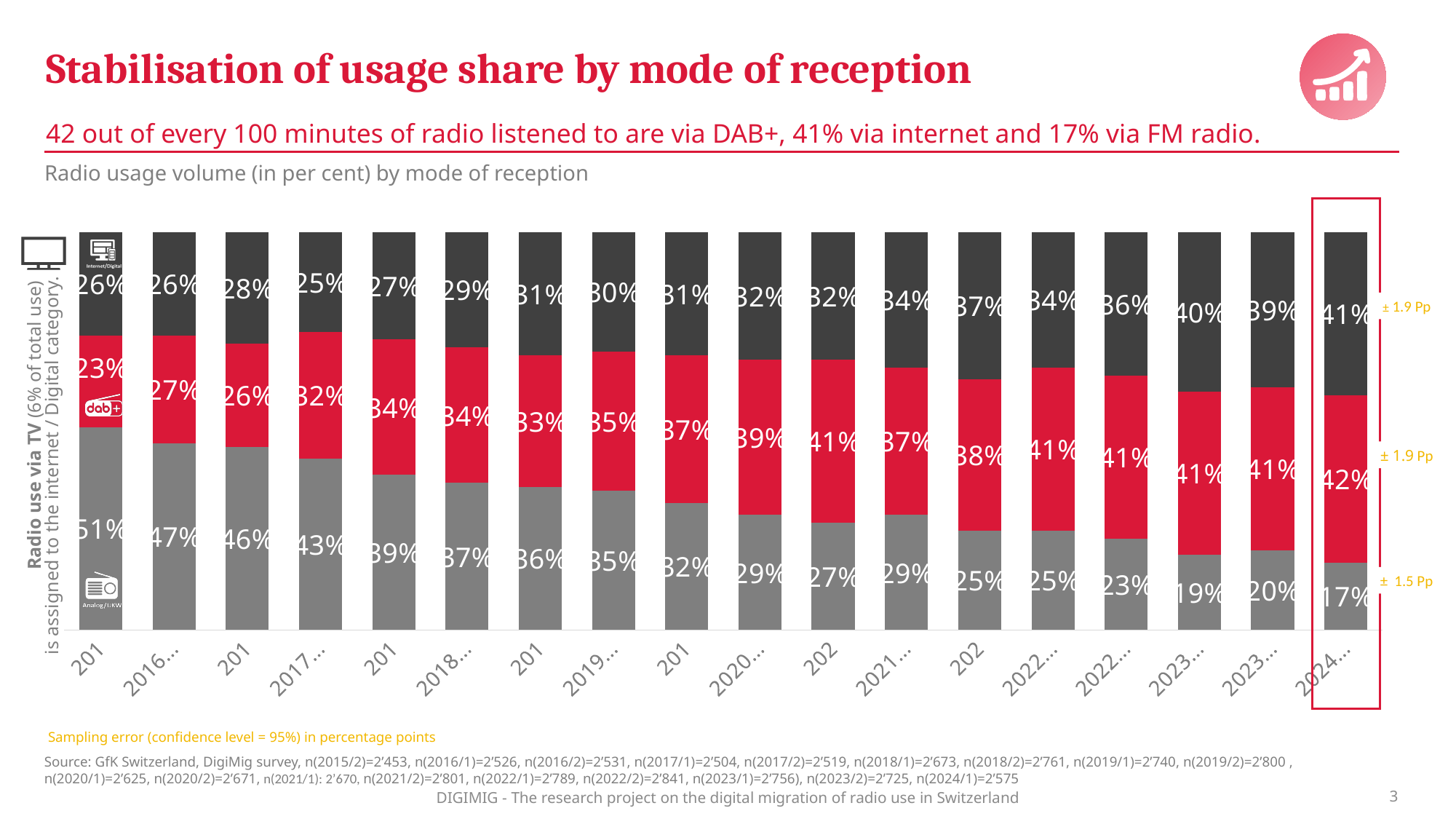
Which bar has the highest FM/analog (grey) share? the leftmost bar In the rightmost (2024) bar, what is the share for FM/analog radio (grey segment)? 17% In the rightmost (2024) bar, which is larger: the DAB+ share or the FM/analog share? DAB+ share What sampling error is shown next to the DAB+ segment of the 2024 bar? ± 1.9 Pp What is the difference between the FM/analog share in the leftmost bar (51%) and in the rightmost 2024 bar (17%)? 34 percentage points Does the FM/analog (grey) share rise or fall from the leftmost bar to the rightmost bar? fall In the leftmost bar, what is the share for FM/analog radio (grey segment)? 51% In the rightmost (2024) bar, what is the share for DAB+ (red segment)? 42% What type of chart is shown on the slide? stacked bar chart In the leftmost bar, what is the share for DAB+ (red segment)? 23% How many bars (time periods) are plotted in the chart? 18 In the rightmost (2024) bar, what is the share for internet/digital (dark segment)? 41%